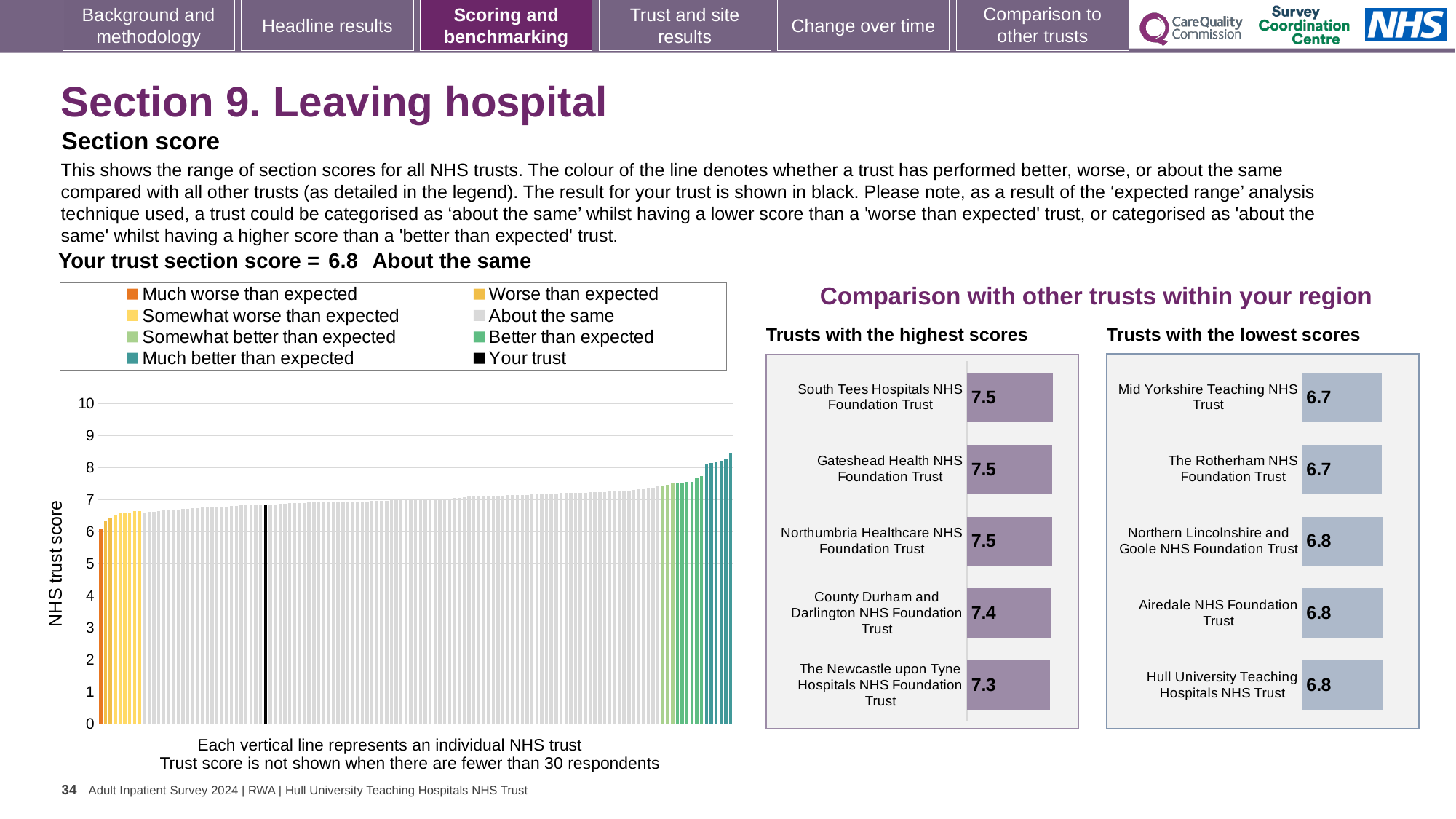
In the 'Trusts with the highest scores' chart, which trust has the lowest score? The Newcastle upon Tyne Hospitals NHS Foundation Trust How many entries does the legend of the main NHS trust score chart list? 8 In the 'Trusts with the highest scores' chart, what is the score for The Newcastle upon Tyne Hospitals NHS Foundation Trust? 7.3 What kind of chart is the main chart showing NHS trust scores on the left of the slide? Bar chart How many trusts are shown in the 'Trusts with the lowest scores' chart? 5 In the main NHS trust score chart, do the bars rise or fall from left to right? Rise In the 'Trusts with the lowest scores' chart, what is the score for Hull University Teaching Hospitals NHS Trust? 6.8 In the 'Trusts with the highest scores' chart, which has the larger score: County Durham and Darlington NHS Foundation Trust or The Newcastle upon Tyne Hospitals NHS Foundation Trust? County Durham and Darlington NHS Foundation Trust In the 'Trusts with the lowest scores' chart, what is the score for Mid Yorkshire Teaching NHS Trust? 6.7 In the 'Trusts with the highest scores' chart, what is the score for South Tees Hospitals NHS Foundation Trust? 7.5 In the 'Trusts with the highest scores' chart, what is the difference between the scores of South Tees Hospitals NHS Foundation Trust and The Newcastle upon Tyne Hospitals NHS Foundation Trust? 0.2 In the main NHS trust score chart, is the value of the tallest bar greater or less than 8? greater